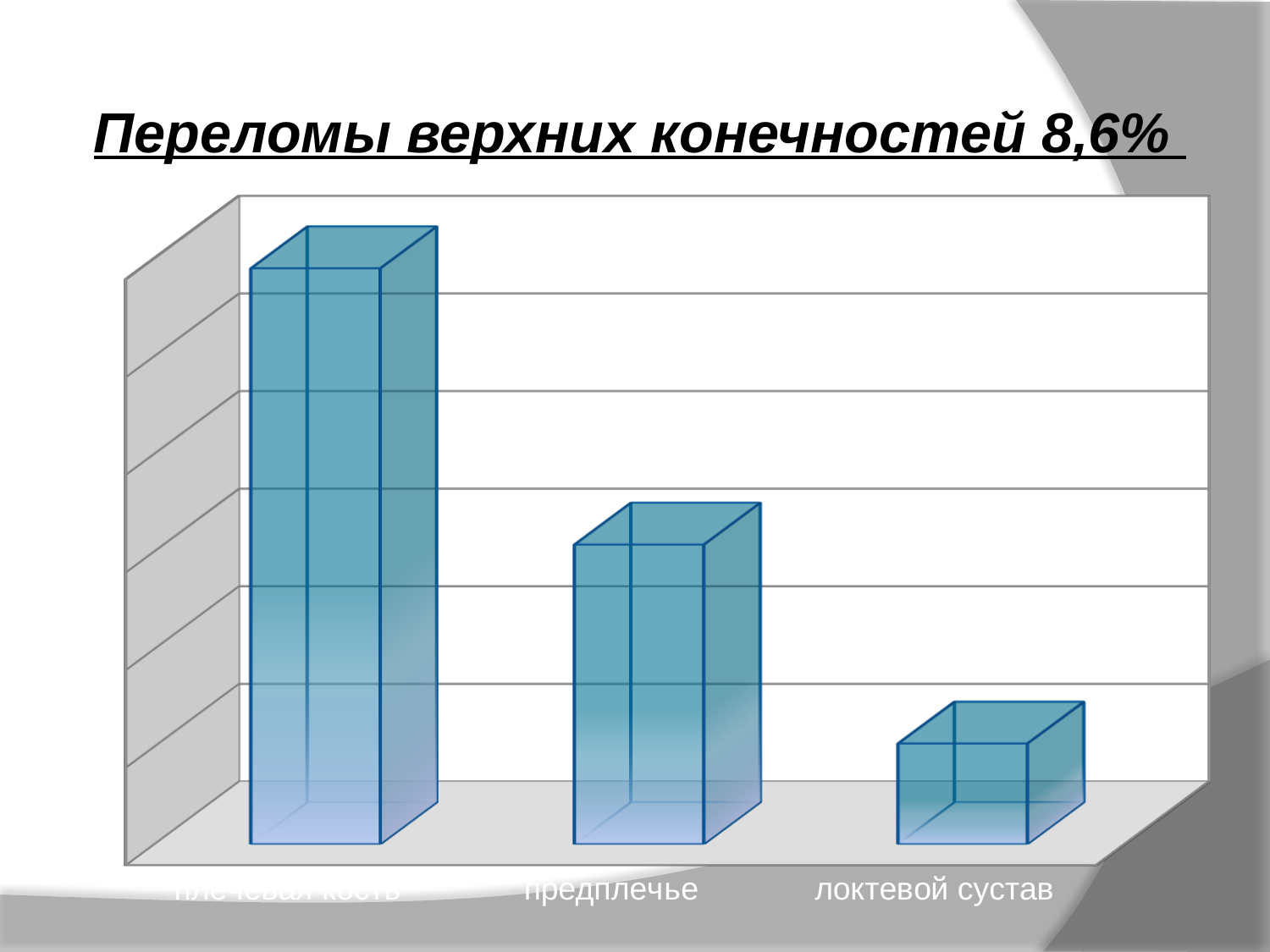
What is the label of the rightmost category in the chart? локтевой сустав Which is larger, the bar for плечевая кость or the bar for предплечье? плечевая кость Which category has the highest bar in the chart? плечевая кость Which category has the lowest bar in the chart? локтевой сустав What kind of chart is shown on the slide? bar chart Do the bar values rise or fall from left to right across the categories? fall How many categories (bars) are plotted in the chart? 3 What is the title of the slide containing the chart? Переломы верхних конечностей 8,6% Which is larger, the bar for предплечье or the bar for локтевой сустав? предплечье